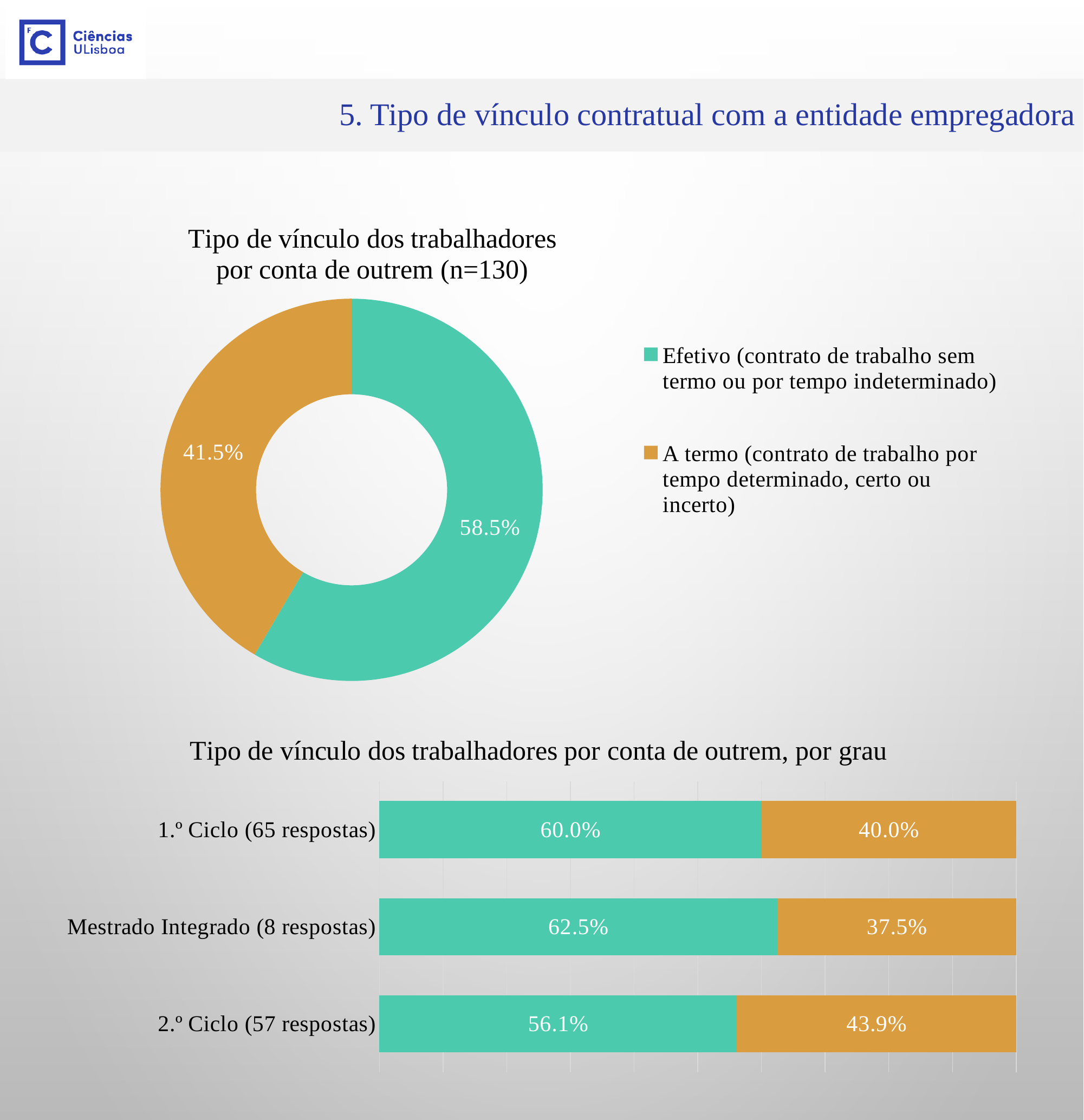
In the bottom chart 'Tipo de vínculo dos trabalhadores por conta de outrem, por grau', which degree has the highest teal (Efetivo) share? Mestrado Integrado (8 respostas) In the bottom chart 'Tipo de vínculo dos trabalhadores por conta de outrem, por grau', what is the teal (Efetivo) value for 1.º Ciclo (65 respostas)? 60.0% In the bottom chart 'Tipo de vínculo dos trabalhadores por conta de outrem, por grau', which degree has the lowest teal (Efetivo) share? 2.º Ciclo (57 respostas) How many entries does the legend of the top chart 'Tipo de vínculo dos trabalhadores por conta de outrem (n=130)' list? 2 In the top chart 'Tipo de vínculo dos trabalhadores por conta de outrem (n=130)', what share is labelled for A termo (contrato de trabalho por tempo determinado, certo ou incerto)? 41.5% In the top chart 'Tipo de vínculo dos trabalhadores por conta de outrem (n=130)', what is the difference in percentage points between the Efetivo and A termo shares? 17.0 percentage points In the bottom chart 'Tipo de vínculo dos trabalhadores por conta de outrem, por grau', what is the orange (A termo) value for 2.º Ciclo (57 respostas)? 43.9% In the bottom chart 'Tipo de vínculo dos trabalhadores por conta de outrem, por grau', what is the total of the two segments for Mestrado Integrado (8 respostas)? 100.0% In the top chart 'Tipo de vínculo dos trabalhadores por conta de outrem (n=130)', which category has the larger share? Efetivo (contrato de trabalho sem termo ou por tempo indeterminado) In the bottom chart 'Tipo de vínculo dos trabalhadores por conta de outrem, por grau', how many degree categories are shown? 3 What kind of chart is the top chart 'Tipo de vínculo dos trabalhadores por conta de outrem (n=130)'? Doughnut chart In the top chart 'Tipo de vínculo dos trabalhadores por conta de outrem (n=130)', what share is labelled for Efetivo (contrato de trabalho sem termo ou por tempo indeterminado)? 58.5%